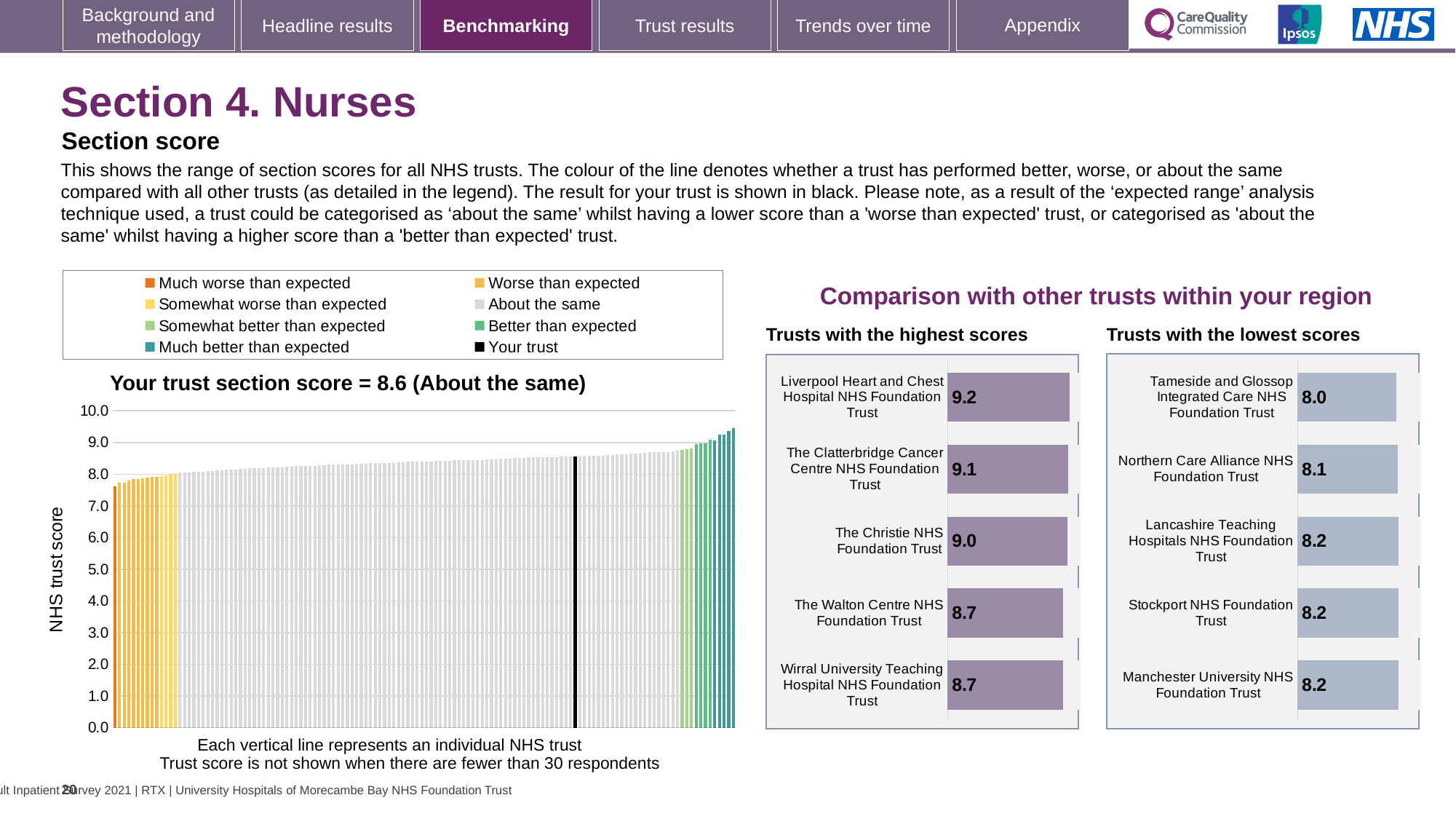
How many entries does the legend above the main chart list? 8 In the 'Trusts with the lowest scores' chart, what is the score for Northern Care Alliance NHS Foundation Trust? 8.1 In the 'Trusts with the highest scores' chart, what is the difference between the scores of Liverpool Heart and Chest Hospital NHS Foundation Trust and The Christie NHS Foundation Trust? 0.2 In the main chart 'Your trust section score', what category is your trust placed in? About the same How many trusts are shown in the 'Trusts with the lowest scores' chart? 5 What kind of chart is the main chart showing the range of section scores for all NHS trusts? bar chart What is the label on the y axis of the main chart? NHS trust score In the 'Trusts with the highest scores' chart, what is the score for Liverpool Heart and Chest Hospital NHS Foundation Trust? 9.2 In the main chart 'Your trust section score', what is the section score for your trust? 8.6 In the 'Trusts with the lowest scores' chart, which trust has the lowest score? Tameside and Glossop Integrated Care NHS Foundation Trust In the 'Trusts with the highest scores' chart, which trust has the highest score? Liverpool Heart and Chest Hospital NHS Foundation Trust In the main chart, do the trust scores rise or fall from left to right along the x axis? rise